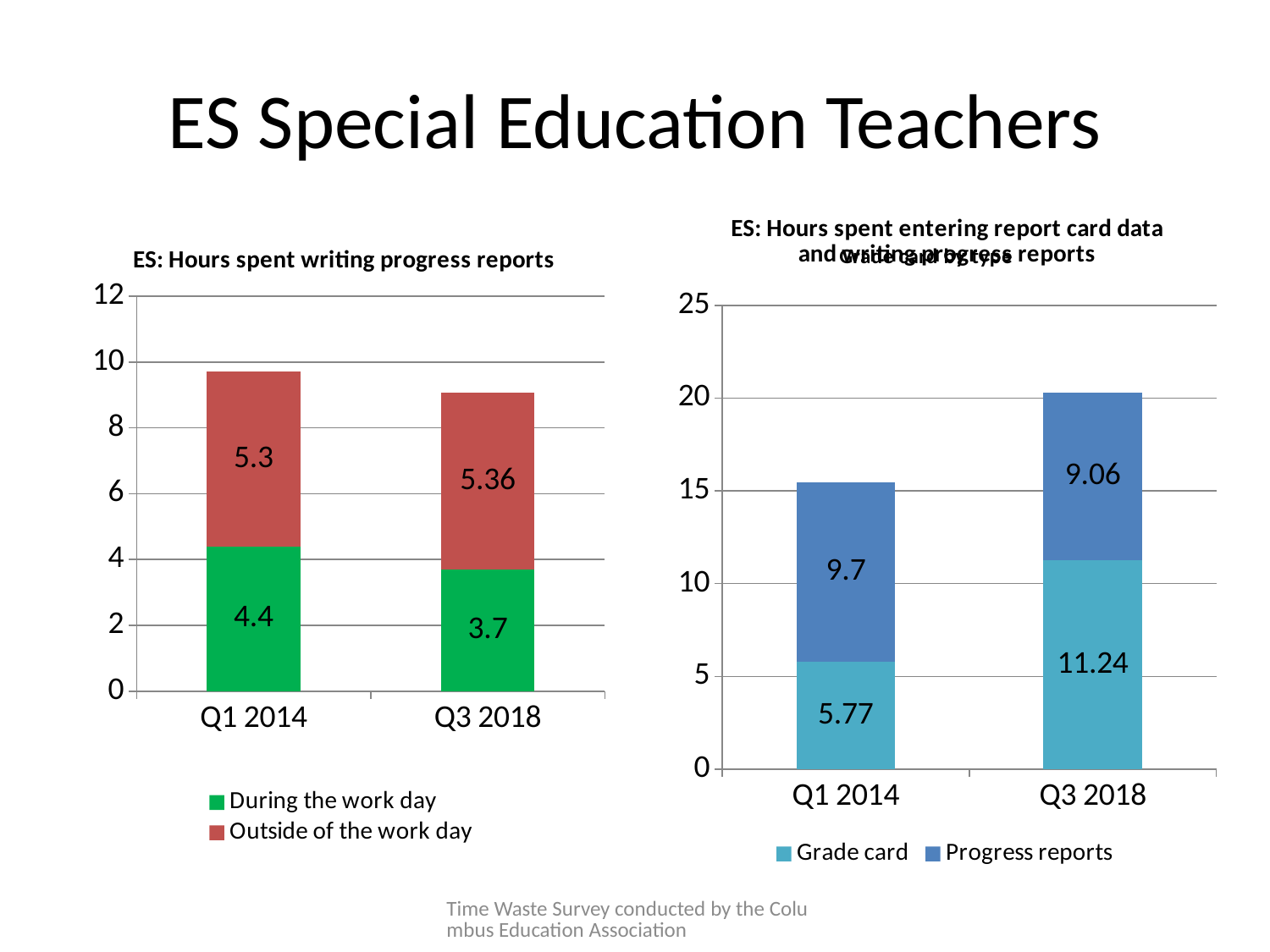
What kind of chart is the right chart? Stacked bar chart In the right chart, is the total for Q1 2014 greater or less than 15? greater In the left chart, what is the difference between the 'During the work day' values for Q1 2014 and Q3 2018? 0.7 In the right chart, which is larger in Q3 2018: 'Grade card' or 'Progress reports'? Grade card How many series does the legend of the left chart list? 2 In the right chart, what is the value for 'Progress reports' in Q1 2014? 9.7 In the right chart, what is the value for 'Grade card' in Q3 2018? 11.24 In the left chart, what is the value for 'Outside of the work day' in Q3 2018? 5.36 In the left chart, what is the value for 'During the work day' in Q1 2014? 4.4 In the right chart, what is the total of the stacked bar for Q3 2018? 20.3 In the left chart, what is the total of the stacked bar for Q1 2014? 9.7 In the right chart, what is the difference between the 'Grade card' values for Q3 2018 and Q1 2014? 5.47